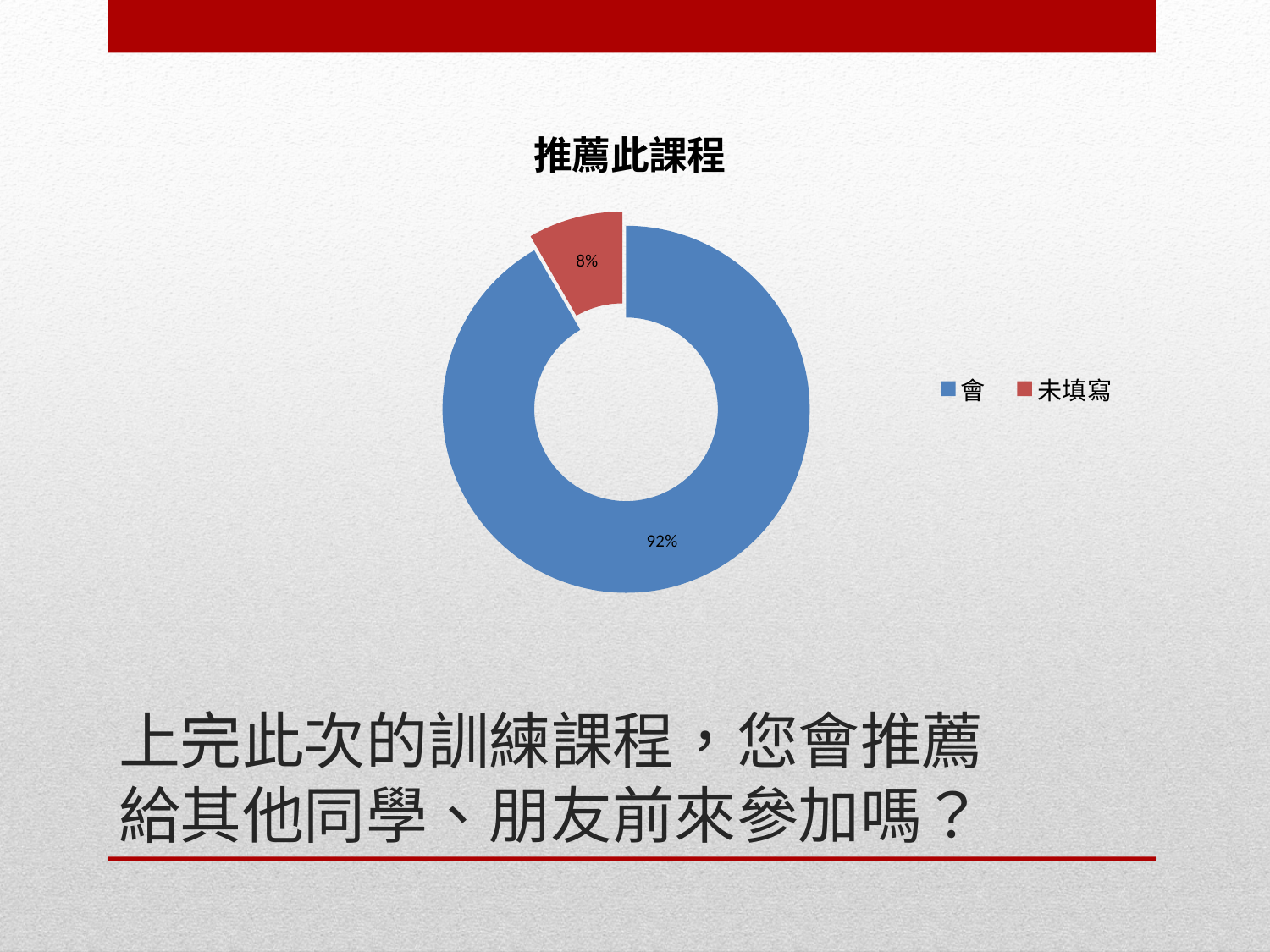
What kind of chart is shown on the slide? Doughnut (pie) chart Which is larger, the share for 會 or the share for 未填寫? 會 What is the difference in percentage points between 會 and 未填寫? 84 How many entries does the legend list? 2 What is the total of the two slices shown? 100% Which category has the smallest share? 未填寫 Which category has the largest share? 會 How many categories are shown in the chart? 2 What share of the chart does 會 represent? 92% What colour is the slice for 未填寫? Red What share of the chart does 未填寫 represent? 8% What is the title of the chart? 推薦此課程